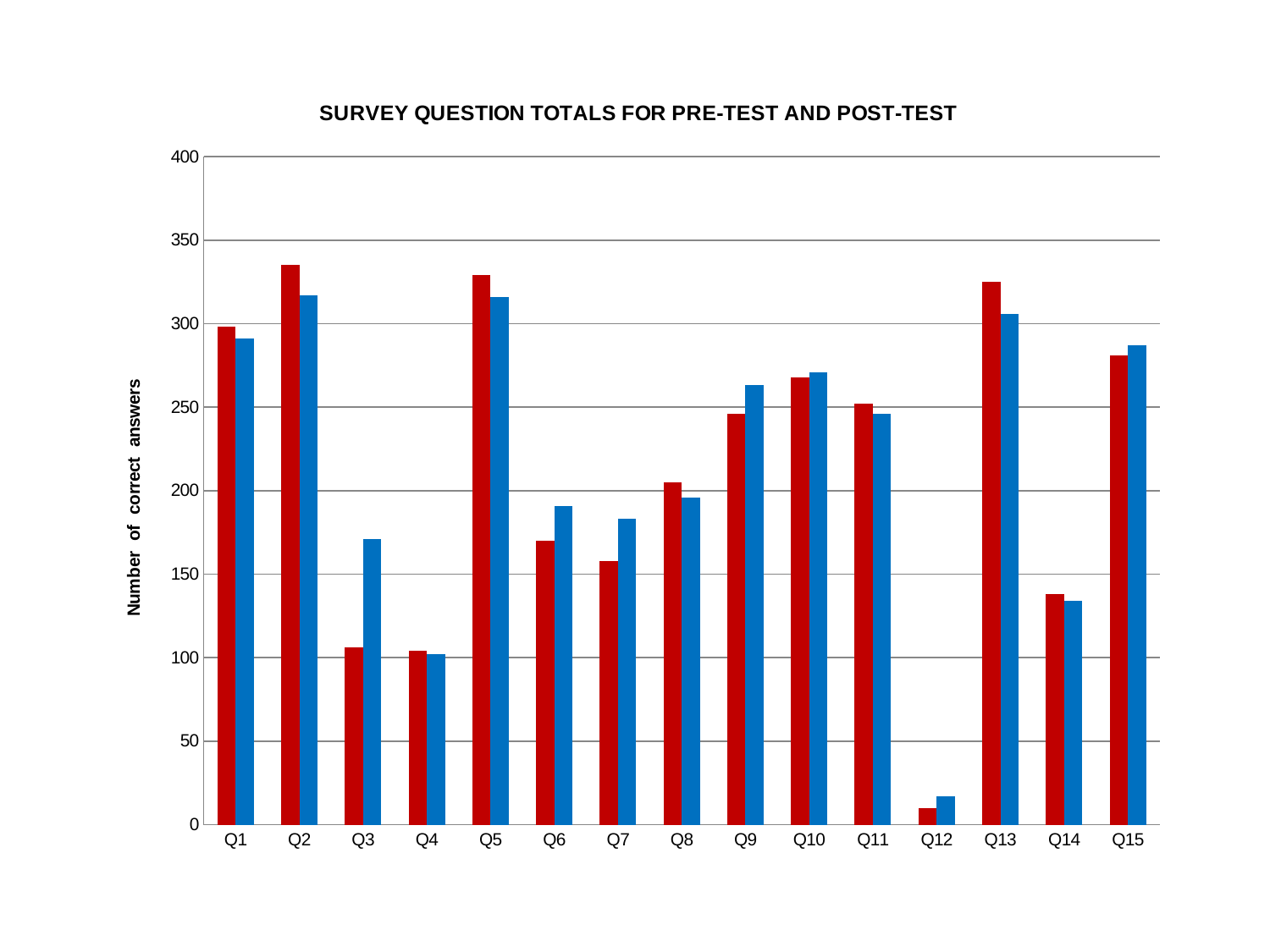
What is the label on the vertical axis? Number of correct answers Which question has the lowest blue bar? Q12 For Q7, which bar is taller, the red bar or the blue bar? blue bar Is the red bar for Q13 greater or less than 300? greater Is the red bar for Q12 greater or less than 50? less What is the title of the chart? SURVEY QUESTION TOTALS FOR PRE-TEST AND POST-TEST Is the blue bar for Q3 greater or less than 150? greater For Q13, which bar is taller, the red bar or the blue bar? red bar How many survey questions (categories) are shown on the x axis? 15 Which question has the lowest red bar? Q12 What kind of chart is shown on the slide? bar chart